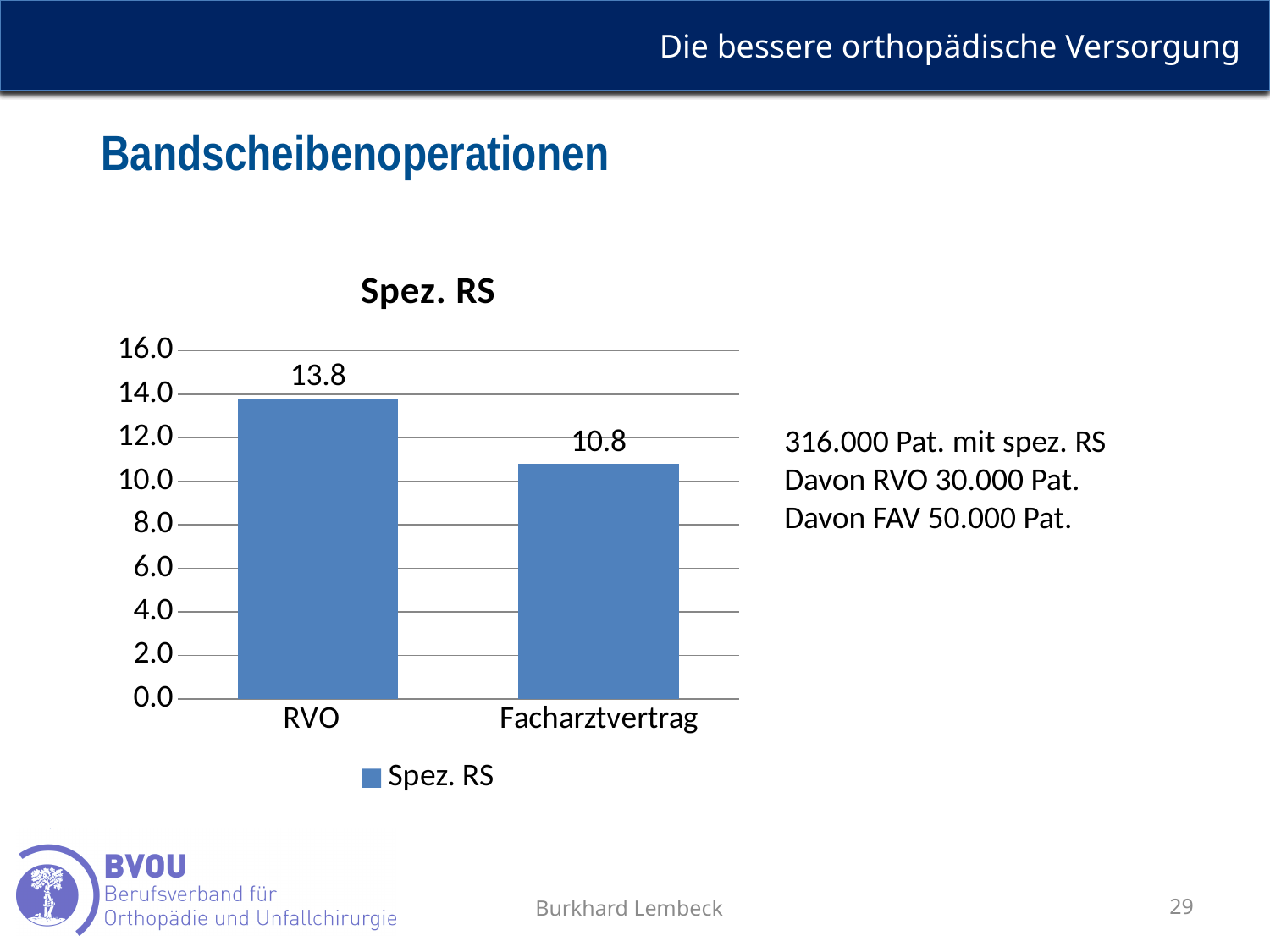
What is the difference between the values for RVO and Facharztvertrag? 3.0 Which is larger, the value for RVO or the value for Facharztvertrag? RVO Which category has the highest value? RVO Is the value for Facharztvertrag greater or less than 12.0? less How many categories are shown on the x axis? 2 Which category has the lowest value? Facharztvertrag What kind of chart is shown? bar chart How many series does the legend list? 1 Is the value for RVO greater or less than 12.0? greater What is the value for RVO? 13.8 What is the title of the chart? Spez. RS What is the value for Facharztvertrag? 10.8